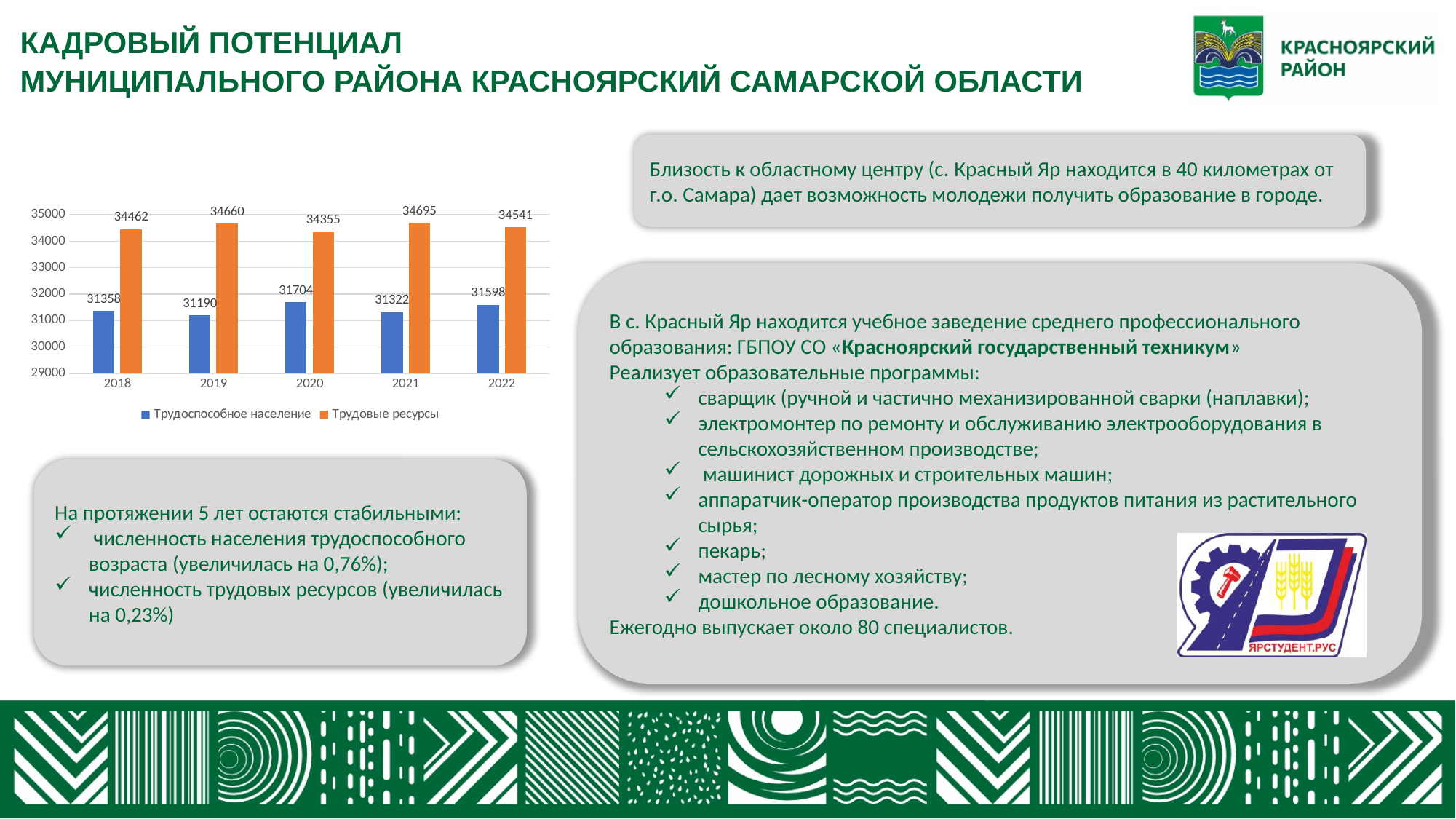
What type of chart is shown on the slide? bar chart In which year is Трудовые ресурсы lowest? 2020 What is the value for Трудоспособное население in 2020? 31704 In which year is Трудоспособное население lowest? 2019 What is the value for Трудовые ресурсы in 2021? 34695 Is the value for Трудоспособное население in 2021 greater or less than 32000? less In which year is Трудоспособное население highest? 2020 How many series does the chart legend list? 2 What is the value for Трудоспособное население in 2019? 31190 Which is larger in 2018: Трудовые ресурсы or Трудоспособное население? Трудовые ресурсы How many years are shown on the x axis of the chart? 5 What is the difference between Трудовые ресурсы and Трудоспособное население in 2022? 2943